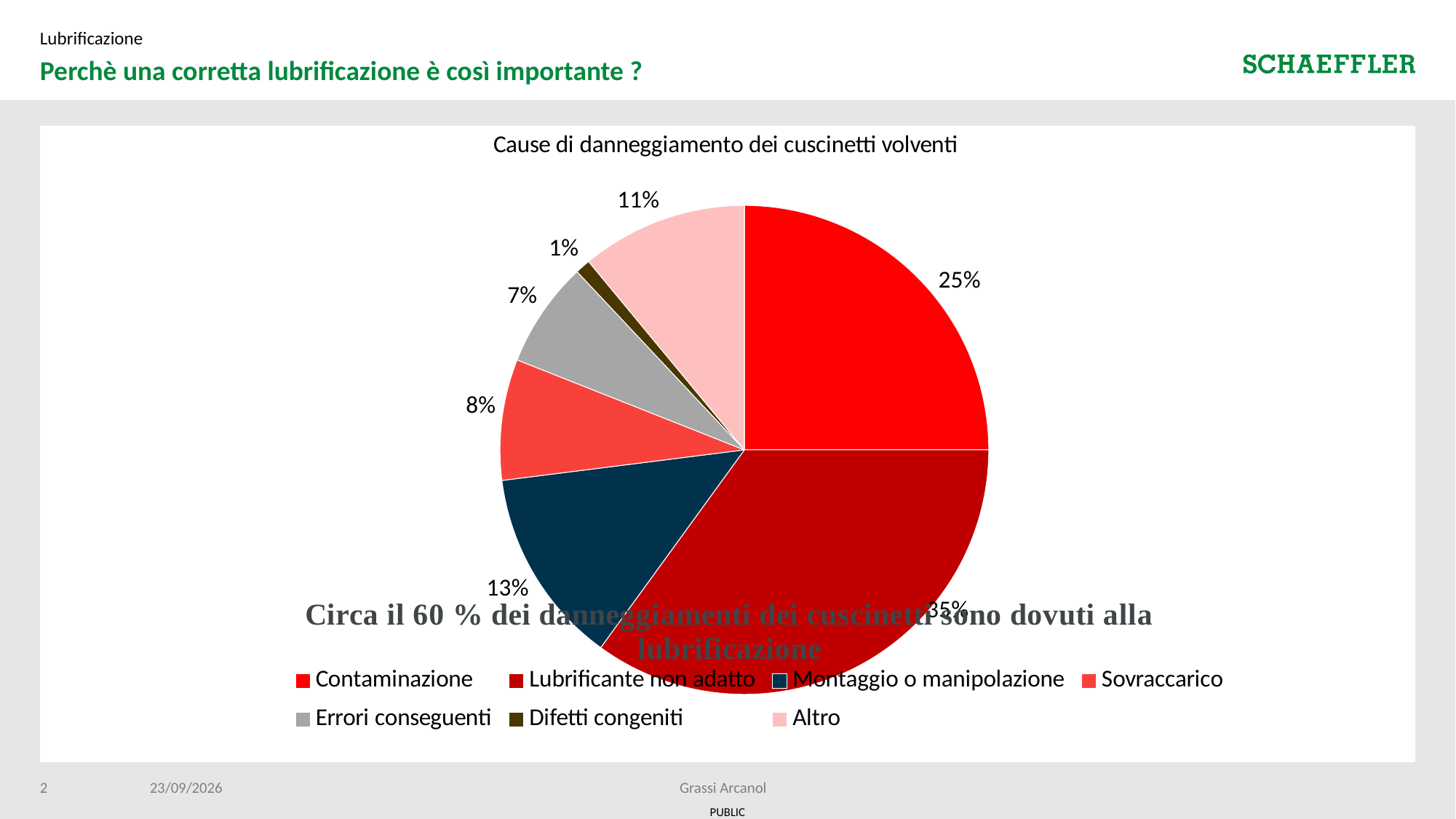
What percentage of bearing damage is attributed to Contaminazione? 25% What type of chart is shown on the slide? pie chart Which is larger, the slice for Contaminazione or the slice for Altro? Contaminazione What is the value shown for Sovraccarico? 8% What is the difference in percentage points between Sovraccarico and Errori conseguenti? 1 What is the value for Altro in the pie chart? 11% Which cause has the smallest slice in the pie chart? Difetti congeniti What percentage is shown for Errori conseguenti? 7% How many categories does the legend of the pie chart list? 7 What is the title of the chart? Cause di danneggiamento dei cuscinetti volventi Which cause has the largest slice in the pie chart? Lubrificante non adatto What share does Montaggio o manipolazione have in the pie chart? 13%